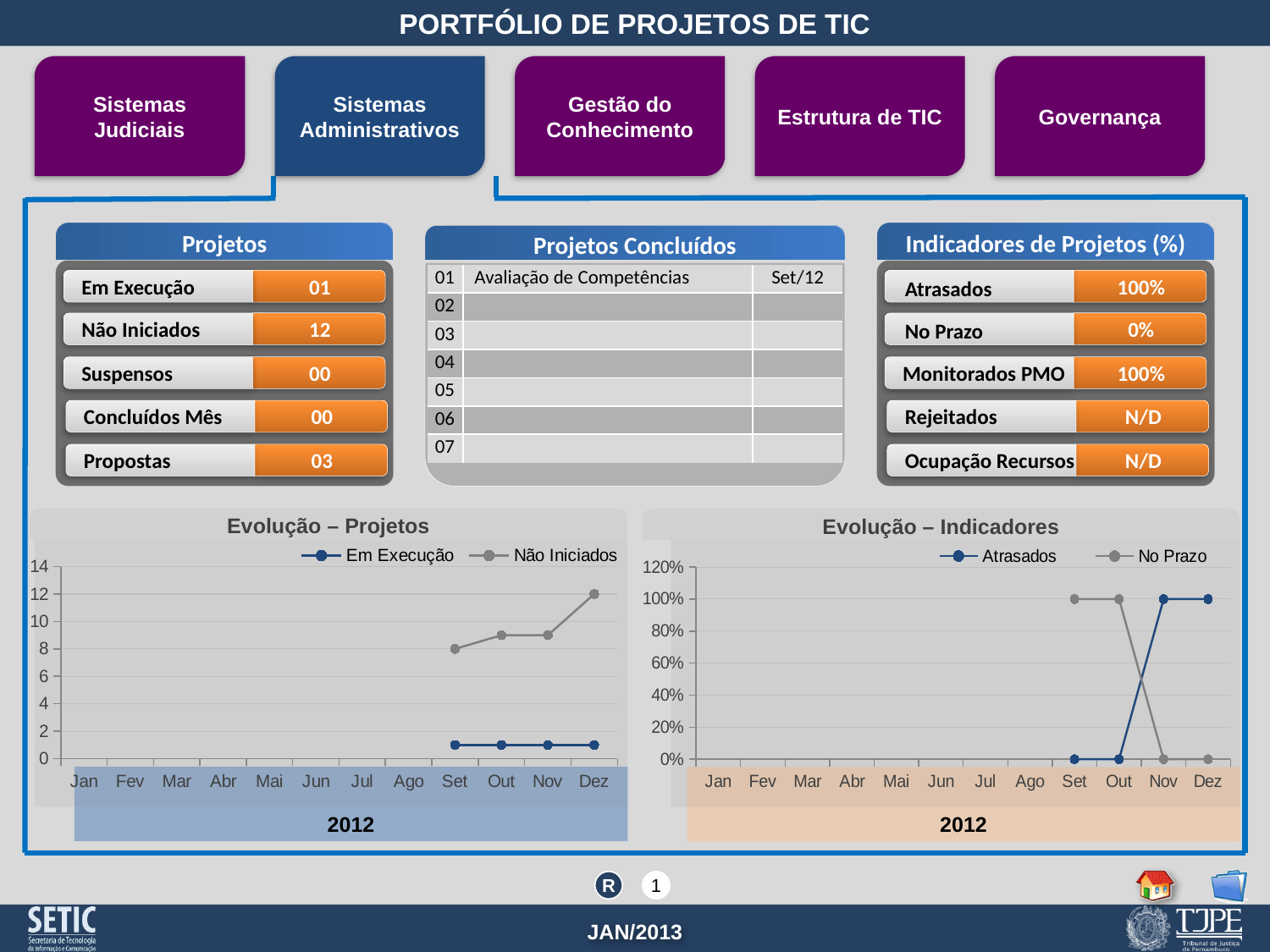
In the "Evolução – Projetos" chart, which series has the higher value in Dez, Em Execução or Não Iniciados? Não Iniciados In the "Evolução – Indicadores" chart, what is the value of Atrasados in Nov? 100% In the "Evolução – Projetos" chart, what is the value of Não Iniciados in Set? 8 In the "Evolução – Projetos" chart, by how much does Não Iniciados increase from Set to Dez? 4 What kind of chart is the "Evolução – Projetos" chart? line chart In the "Evolução – Projetos" chart, does the Não Iniciados series rise or fall from Set to Dez? rise How many series does the legend of the "Evolução – Indicadores" chart list? 2 In the "Evolução – Projetos" chart, what is the value of Não Iniciados in Dez? 12 In the "Evolução – Projetos" chart, is the value for Em Execução in Dez greater or less than 2? less How many series does the legend of the "Evolução – Projetos" chart list? 2 How many months are shown on the x axis of the "Evolução – Indicadores" chart? 12 In the "Evolução – Indicadores" chart, what is the value of No Prazo in Dez? 0%